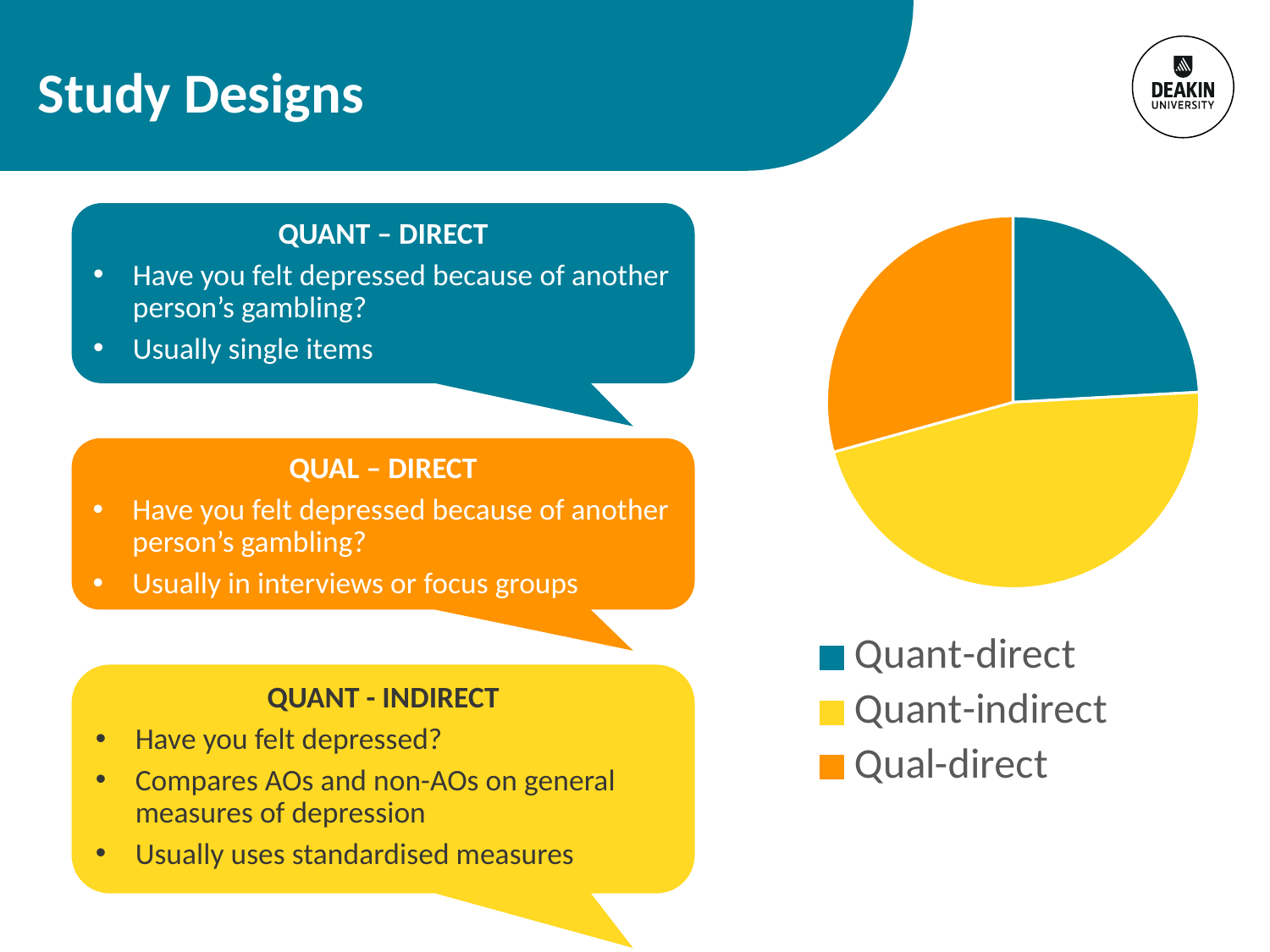
How many entries does the pie chart's legend list? 3 What kind of chart is shown on the right side of the slide? pie chart In the pie chart, which slice is larger: Qual-direct or Quant-indirect? Quant-indirect Which category has the largest slice in the pie chart? Quant-indirect In the pie chart, which slice is larger: Quant-indirect or Quant-direct? Quant-indirect What colour is the Quant-direct slice in the pie chart? teal How many slices does the pie chart have? 3 Which category has the smallest slice in the pie chart? Quant-direct What colour is the Qual-direct slice in the pie chart? orange